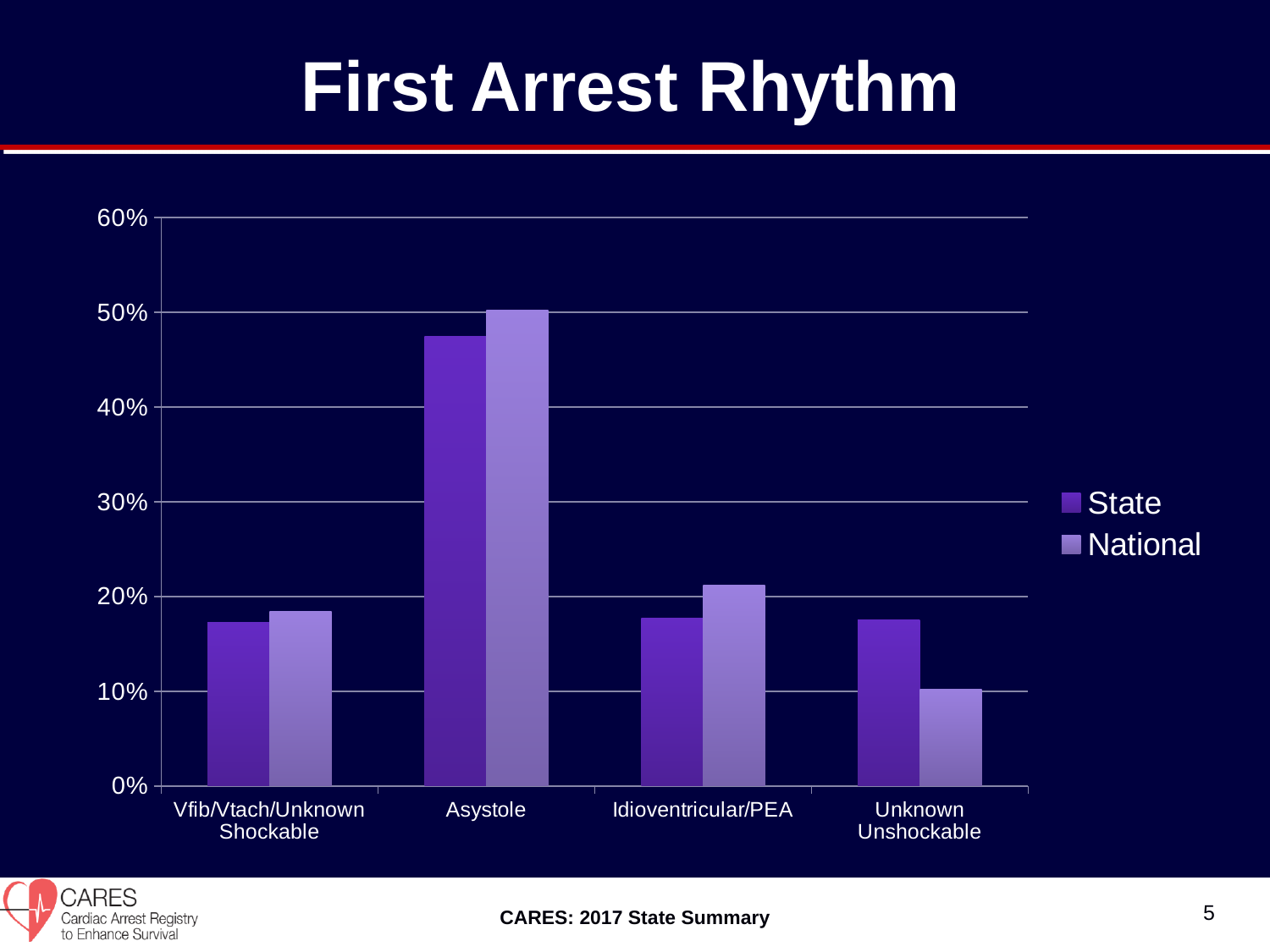
What is the title of the chart on the slide? First Arrest Rhythm How many series does the legend list? 2 Which category has the highest National value? Asystole What are the two series named in the legend? State and National Which category has the lowest National value? Unknown Unshockable For Idioventricular/PEA, which is larger, the State value or the National value? National For Unknown Unshockable, which is larger, the State value or the National value? State Is the National value for Idioventricular/PEA greater or less than 20%? greater What kind of chart is shown on the slide? bar chart Which category has the highest State value? Asystole Is the State value for Asystole greater or less than 50%? less How many first arrest rhythm categories are shown on the x axis? 4